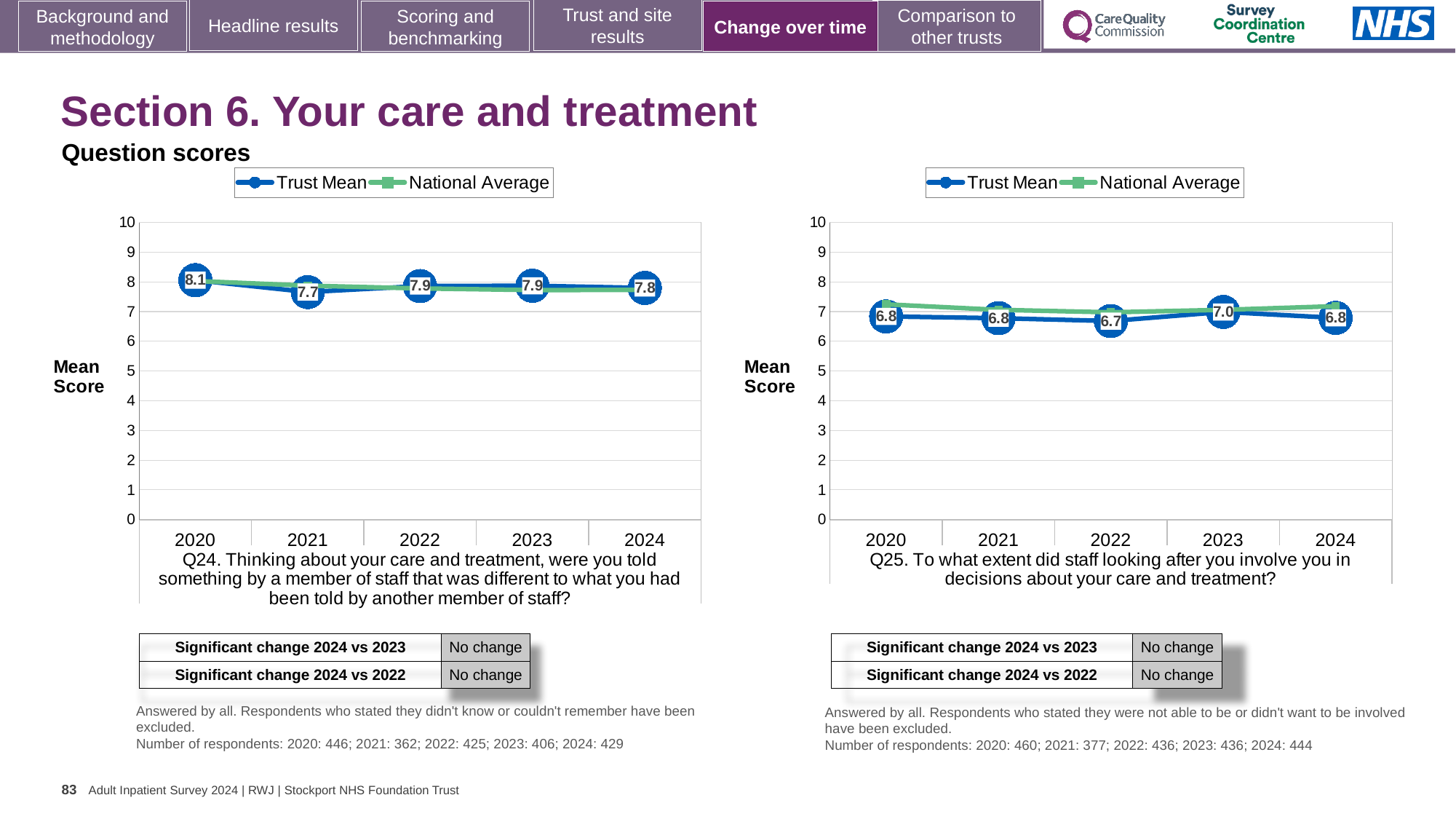
In the Q25 chart, what is the Trust Mean score for 2023? 7.0 How many years are shown on the x axis of the Q24 chart? 5 In the Q25 chart, which year has the highest Trust Mean score? 2023 In the Q24 chart, what is the Trust Mean score for 2021? 7.7 In the Q24 chart, what is the difference between the Trust Mean scores for 2020 and 2021? 0.4 In the Q24 chart, which year has the lowest Trust Mean score? 2021 In the Q25 chart, is the Trust Mean score for 2024 greater or less than 6? greater In the Q24 chart, what is the Trust Mean score for 2020? 8.1 How many series does the legend of the Q25 chart list? 2 In the Q25 chart, what is the Trust Mean score for 2022? 6.7 In the Q24 chart, which year has the highest Trust Mean score? 2020 What type of chart is used for Q24? Line chart